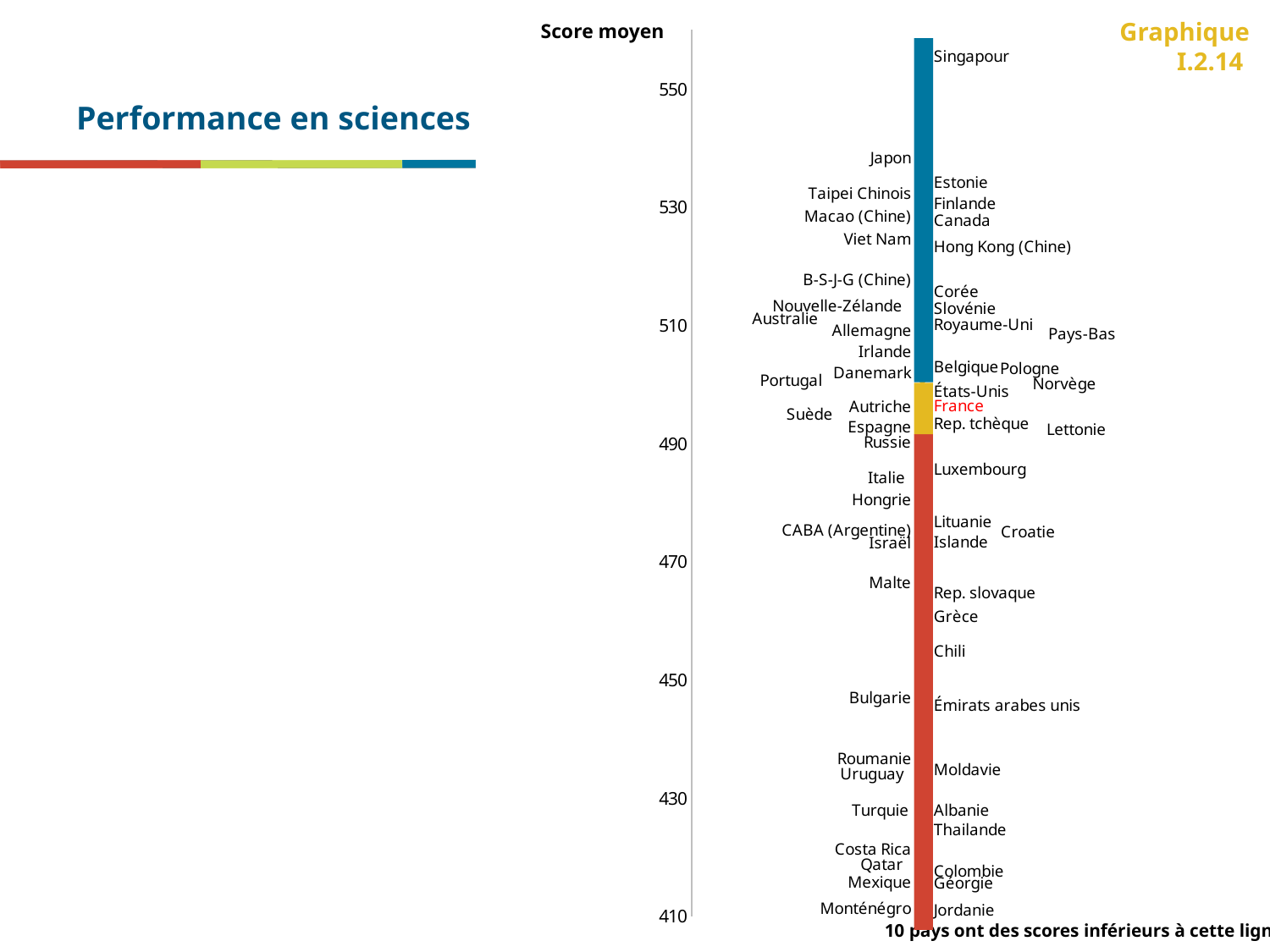
Is the value for Turquie greater or less than 430? less Which country has the highest average science score on the chart? Singapour Is the value for Luxembourg greater or less than 490? less Is the value for Chili greater or less than 450? greater Which has the higher average science score, Japon or Malte? Japon What is the label of the vertical axis on the chart? Score moyen Which has the higher average science score, Bulgarie or Estonie? Estonie Which country's label is highlighted in red on the chart? France